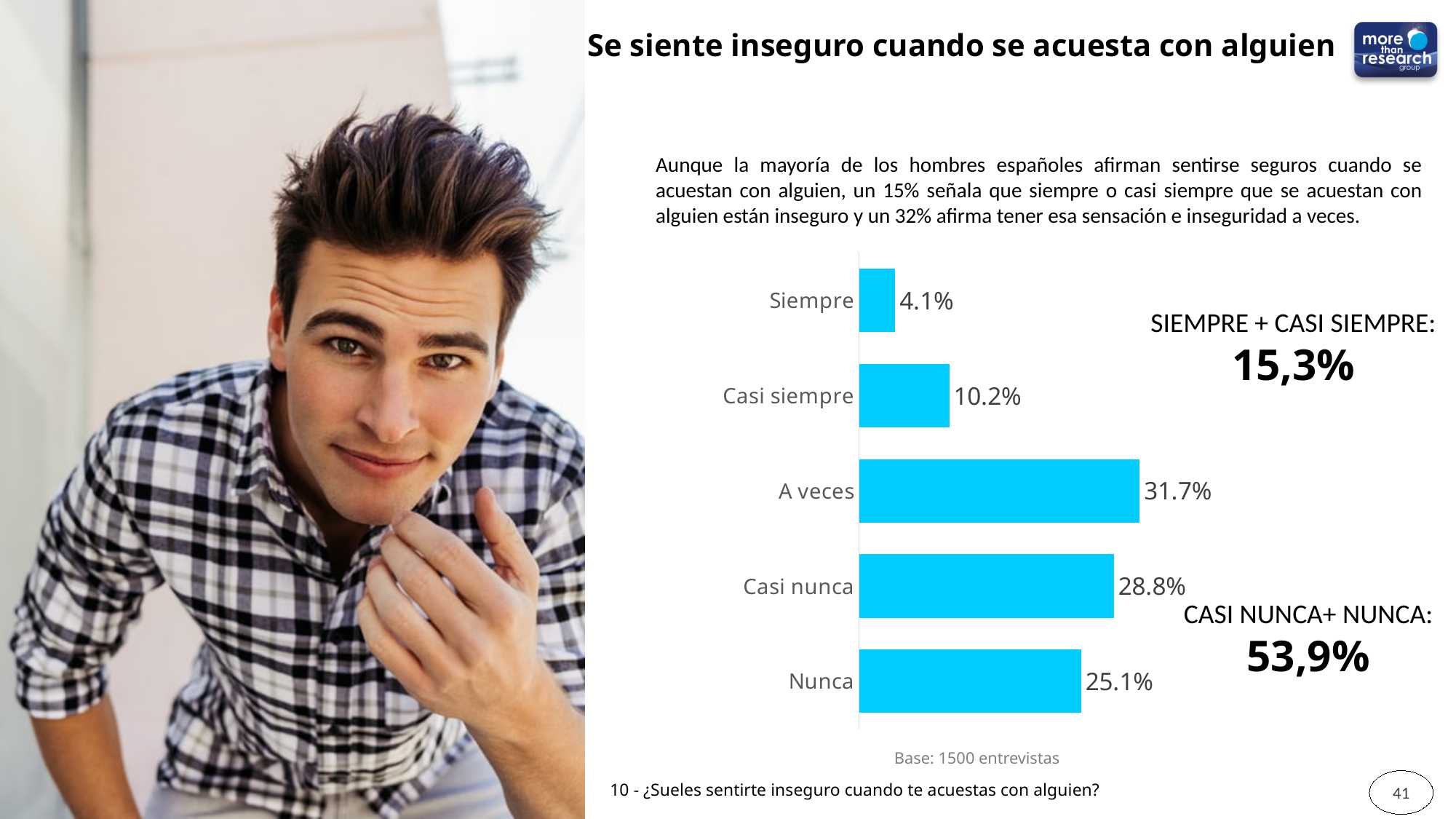
What is the difference between the values for "Casi nunca" and "Nunca"? 3.7% What is the value for "Siempre"? 4.1% What is the value for "A veces"? 31.7% How many categories are shown in the chart? 5 Which category has the lowest value? Siempre What kind of chart is shown on the slide? Bar chart Which is larger, the value for "Casi siempre" or the value for "Nunca"? Nunca What is the value for "Nunca"? 25.1% Which category has the highest value? A veces What is the combined value shown for "SIEMPRE + CASI SIEMPRE"? 15,3% What base (number of interviews) is stated below the chart? 1500 entrevistas What is the value for "Casi siempre"? 10.2%